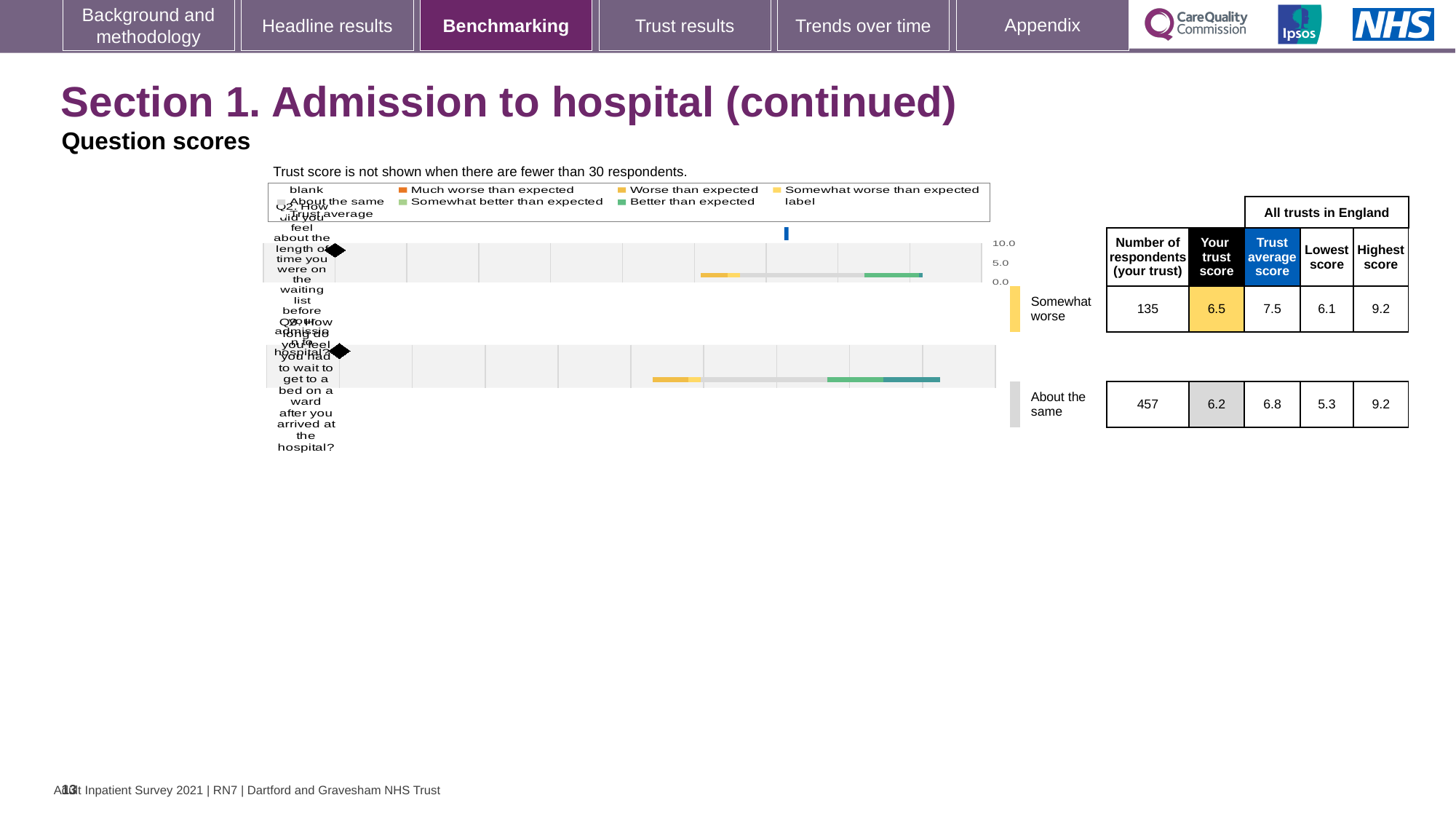
What is the lowest score across all trusts in England for Q3? 5.3 By how much is the trust average score for Q2 higher than this trust's score for Q2? 1.0 What kind of chart is used to show the question scores? Bar chart How many respondents answered Q3 at this trust? 457 Which question had more respondents at this trust, Q2 or Q3? Q3 How many questions are plotted on the chart? 2 What is the trust average score across all trusts in England for Q2? 7.5 What is the trust score for Q2 (length of time on the waiting list before admission)? 6.5 Which benchmark category is this trust's score for Q2 placed in? Somewhat worse What is the highest score across all trusts in England for Q2? 9.2 How many respondents answered Q2 at this trust? 135 What is the trust score for Q3 (wait to get to a bed on a ward after arriving at the hospital)? 6.2